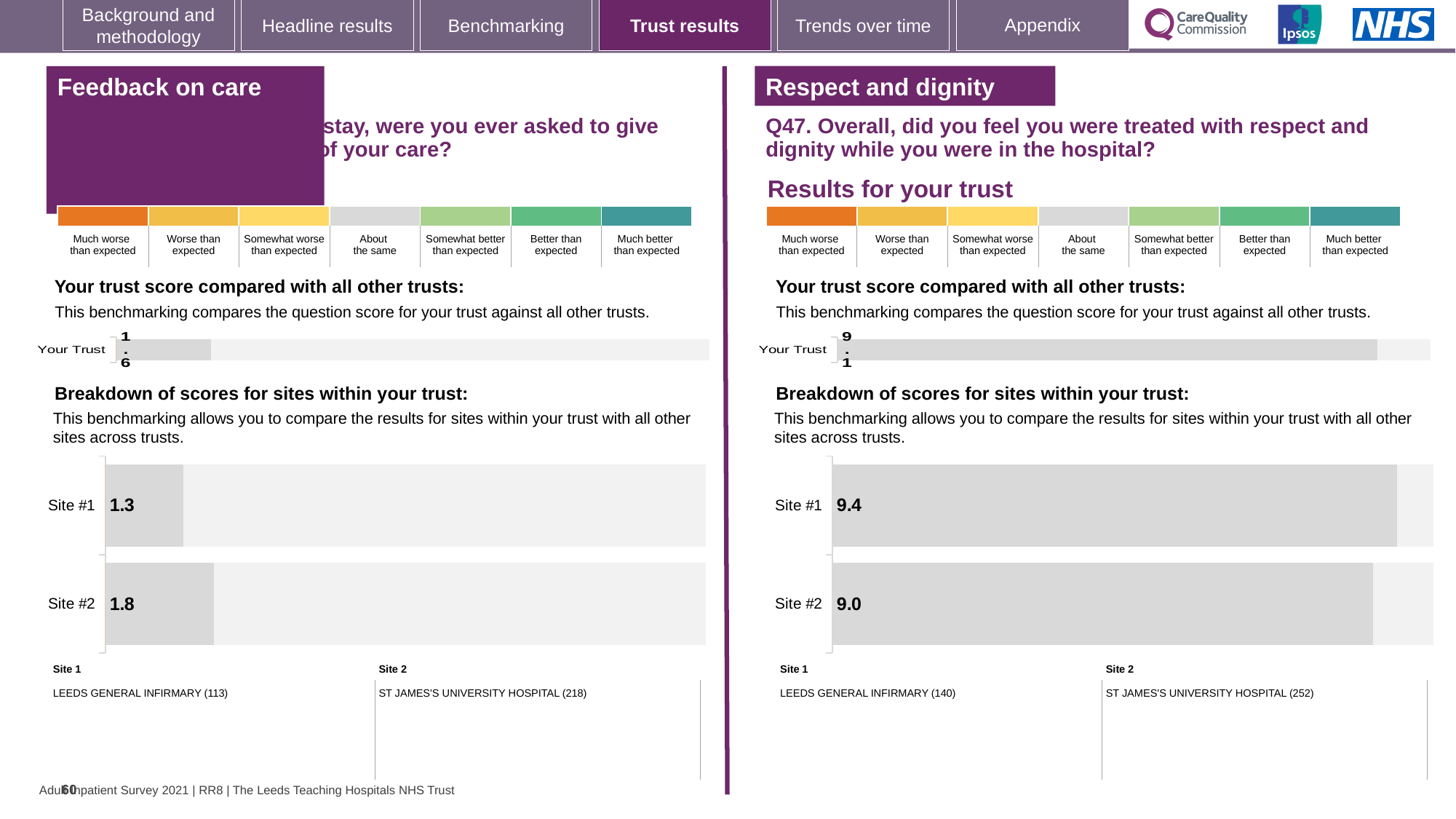
How many sites are shown in the 'Respect and dignity' site breakdown chart on the right? 2 In the 'Feedback on care' site breakdown chart on the left, what is the score for Site #2? 1.8 In the 'Respect and dignity' site breakdown chart on the right, what is the score for Site #2? 9.0 In the 'Feedback on care' site breakdown chart on the left, what is the difference between the Site #2 and Site #1 scores? 0.5 What type of chart is used for the site breakdown of scores on the left side of the slide? Bar chart In the 'Feedback on care' site breakdown chart on the left, what is the score for Site #1? 1.3 In the 'Respect and dignity' site breakdown chart on the right, which site has the lower score? Site #2 In the 'Respect and dignity' trust score chart on the right, what is the score for Your Trust? 9.1 In the 'Feedback on care' site breakdown chart on the left, which site has the higher score? Site #2 In the 'Feedback on care' trust score chart on the left, what is the score for Your Trust? 1.6 In the 'Respect and dignity' site breakdown chart on the right, what is the difference between the Site #1 and Site #2 scores? 0.4 In the 'Respect and dignity' site breakdown chart on the right, what is the score for Site #1? 9.4